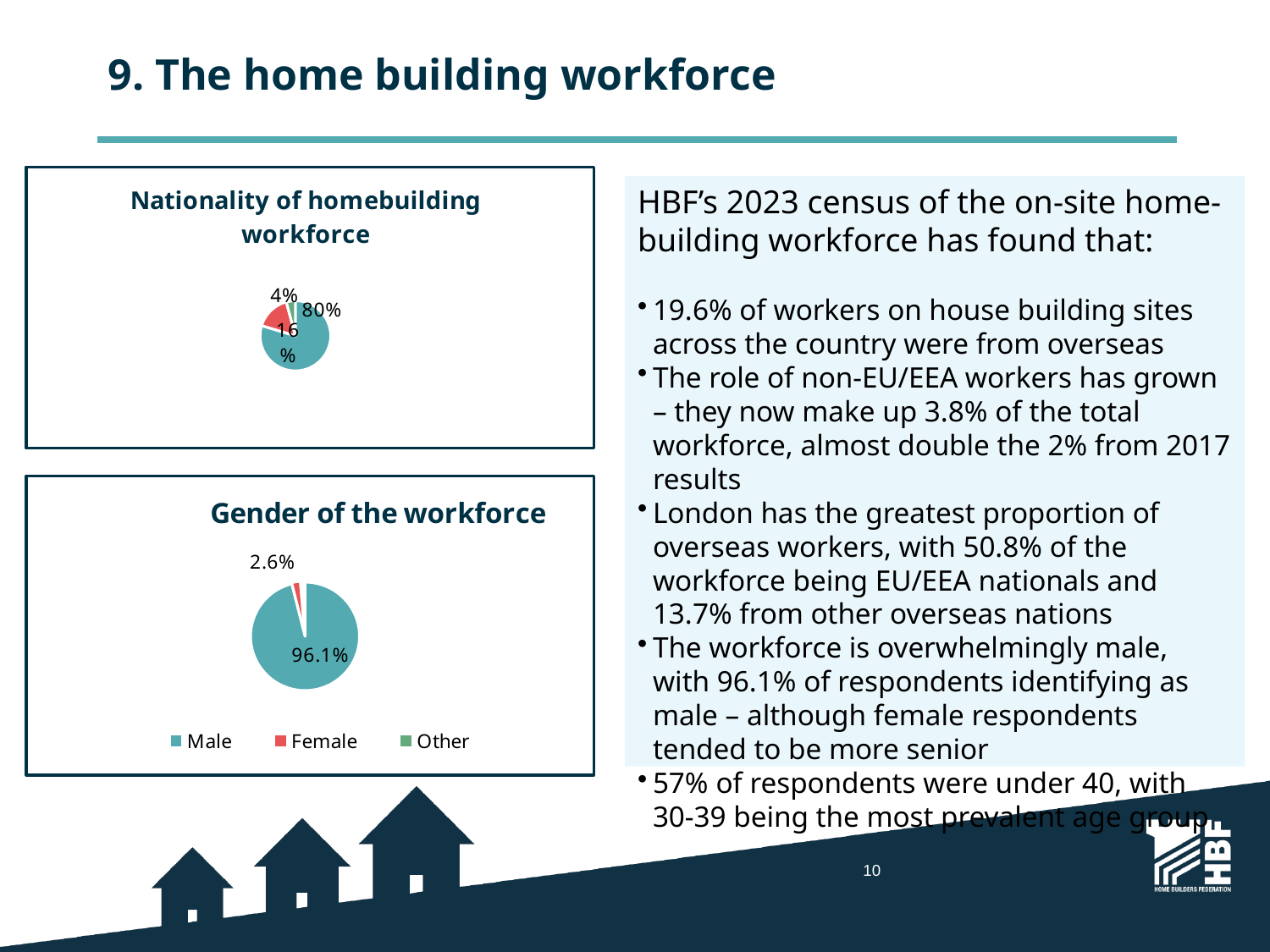
What kind of chart is the 'Gender of the workforce' chart? Pie chart In the 'Gender of the workforce' chart, which is larger, the Male slice or the Female slice? Male In the 'Gender of the workforce' chart, what share of the workforce is Male? 96.1% In the 'Gender of the workforce' chart, what colour is the Male slice? Teal What kind of chart is the 'Nationality of homebuilding workforce' chart? Pie chart In the 'Gender of the workforce' chart, what share of the workforce is Female? 2.6% How many slices are shown in the 'Nationality of homebuilding workforce' chart? 3 In the 'Nationality of homebuilding workforce' chart, what is the value of the largest slice? 80% In the 'Gender of the workforce' chart, which category has the largest slice? Male In the 'Gender of the workforce' chart, how many categories does the legend list? 3 In the 'Gender of the workforce' chart, what is the difference between the Male and Female shares? 93.5% In the 'Nationality of homebuilding workforce' chart, what is the value of the smallest slice? 4%